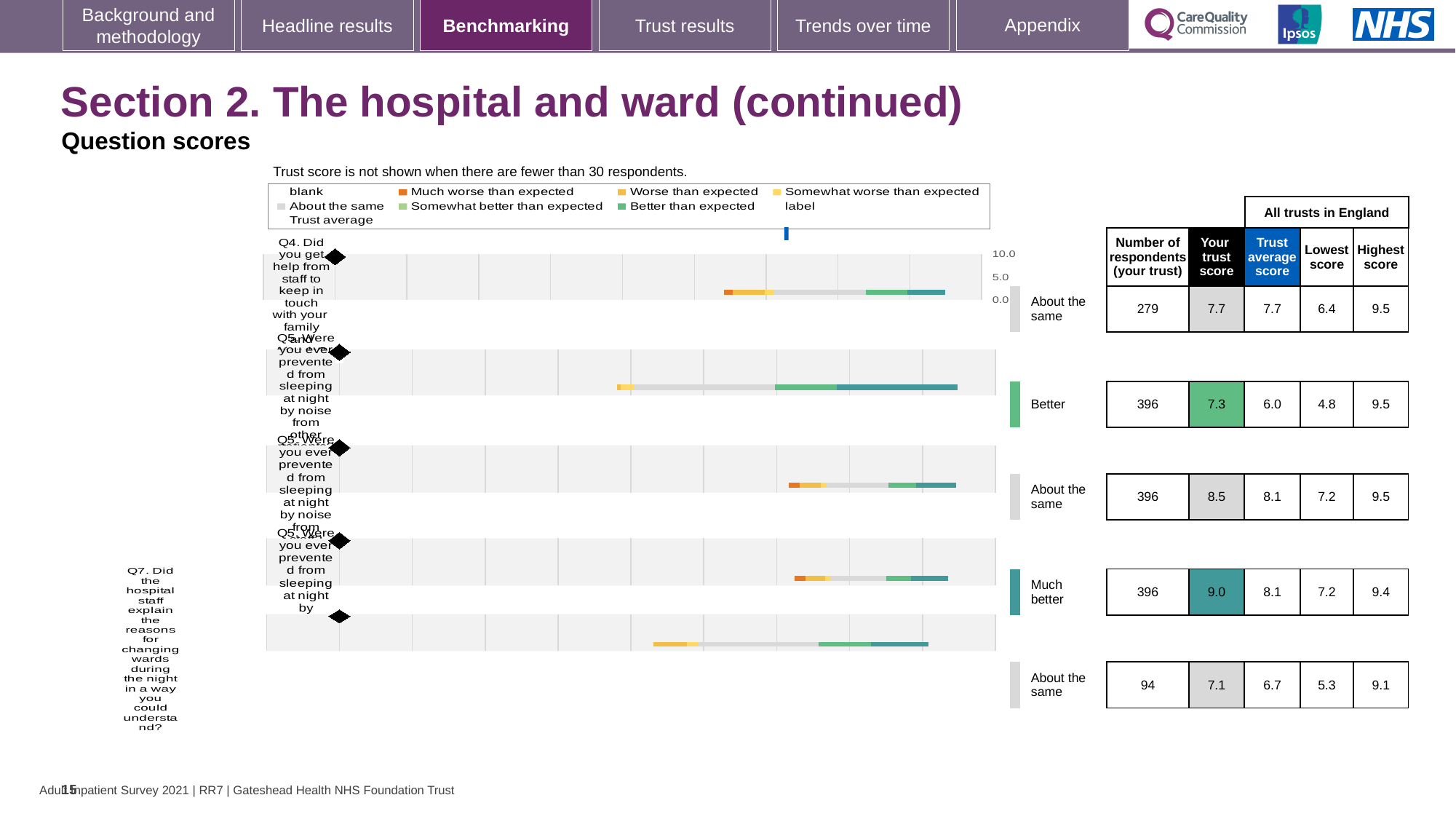
What kind of chart is used to show the question scores on this slide? Bar chart What is the 'Your trust score' for the row rated 'Better'? 7.3 Which row has the highest 'Your trust score'? The row rated 'Much better' (9.0) How many respondents are shown for Q7 (the last row)? 94 Which is larger, the 'Your trust score' for Q4 or for Q7? Q4 What is the 'Trust average score' for the row rated 'Much better'? 8.1 How many question rows are plotted in the chart? 5 What is the 'Your trust score' for Q4 (the first row)? 7.7 For the row rated 'Better', how much higher is 'Your trust score' than the 'Trust average score'? 1.3 Which row has the lowest 'Your trust score'? Q7 (7.1) What is the 'Lowest score' for Q4 (the first row)? 6.4 What is the 'Your trust score' for Q7 (the last row)? 7.1